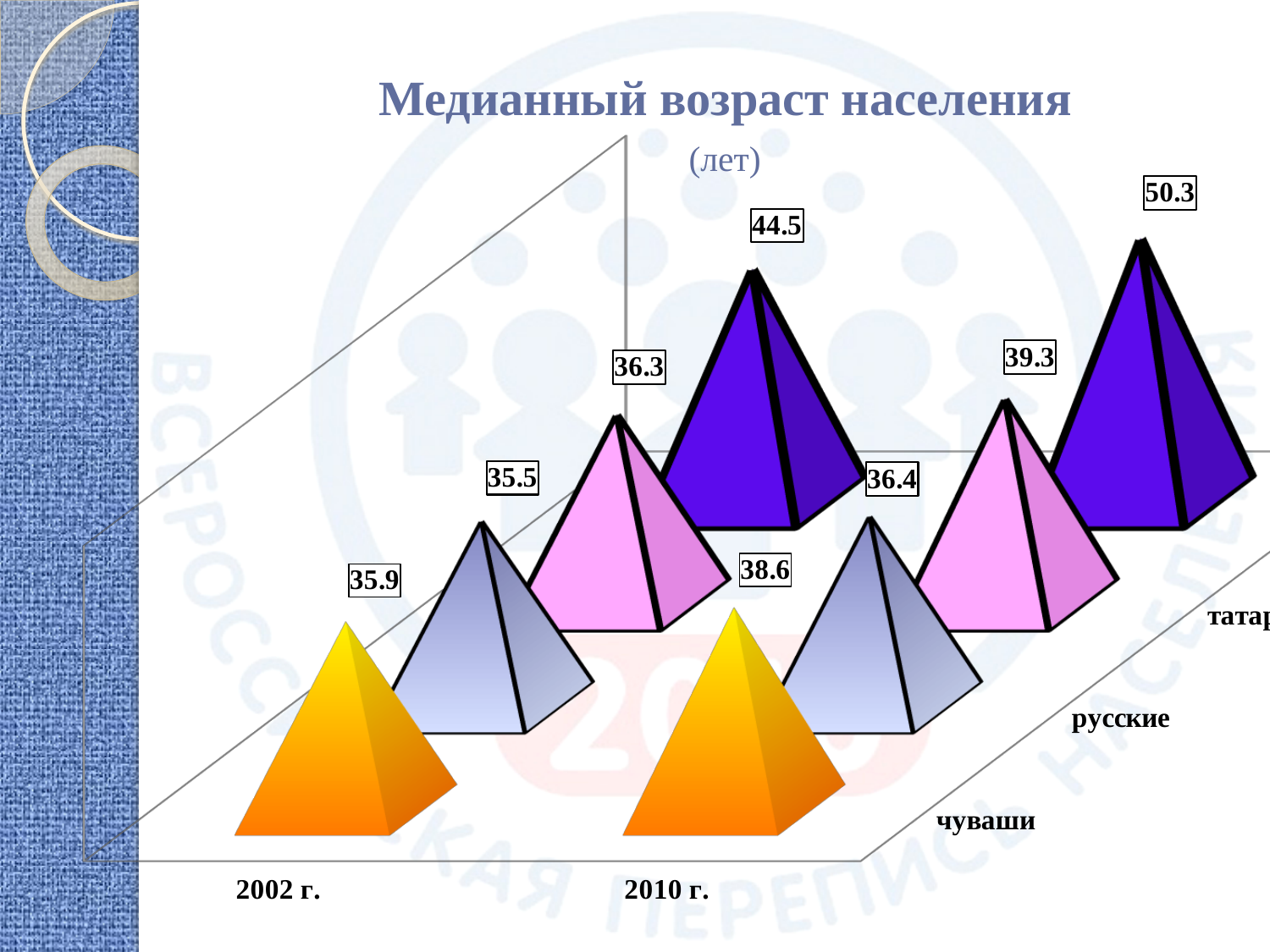
What is the highest value labelled on the chart? 50.3 What is the median age for русские in 2010 г.? 36.4 In 2010 г., which group has the higher median age, чуваши or русские? чуваши What kind of chart is shown on the slide? bar chart How many years are shown along the x axis of the chart? 2 By how much did the median age for чуваши change from 2002 г. to 2010 г.? 2.7 By how much did the median age for русские change from 2002 г. to 2010 г.? 0.9 What is the median age for русские in 2002 г.? 35.5 What is the median age for чуваши in 2010 г.? 38.6 What is the title of the chart? Медианный возраст населения Does the median age for чуваши rise or fall from 2002 г. to 2010 г.? rise What is the median age for чуваши in 2002 г.? 35.9